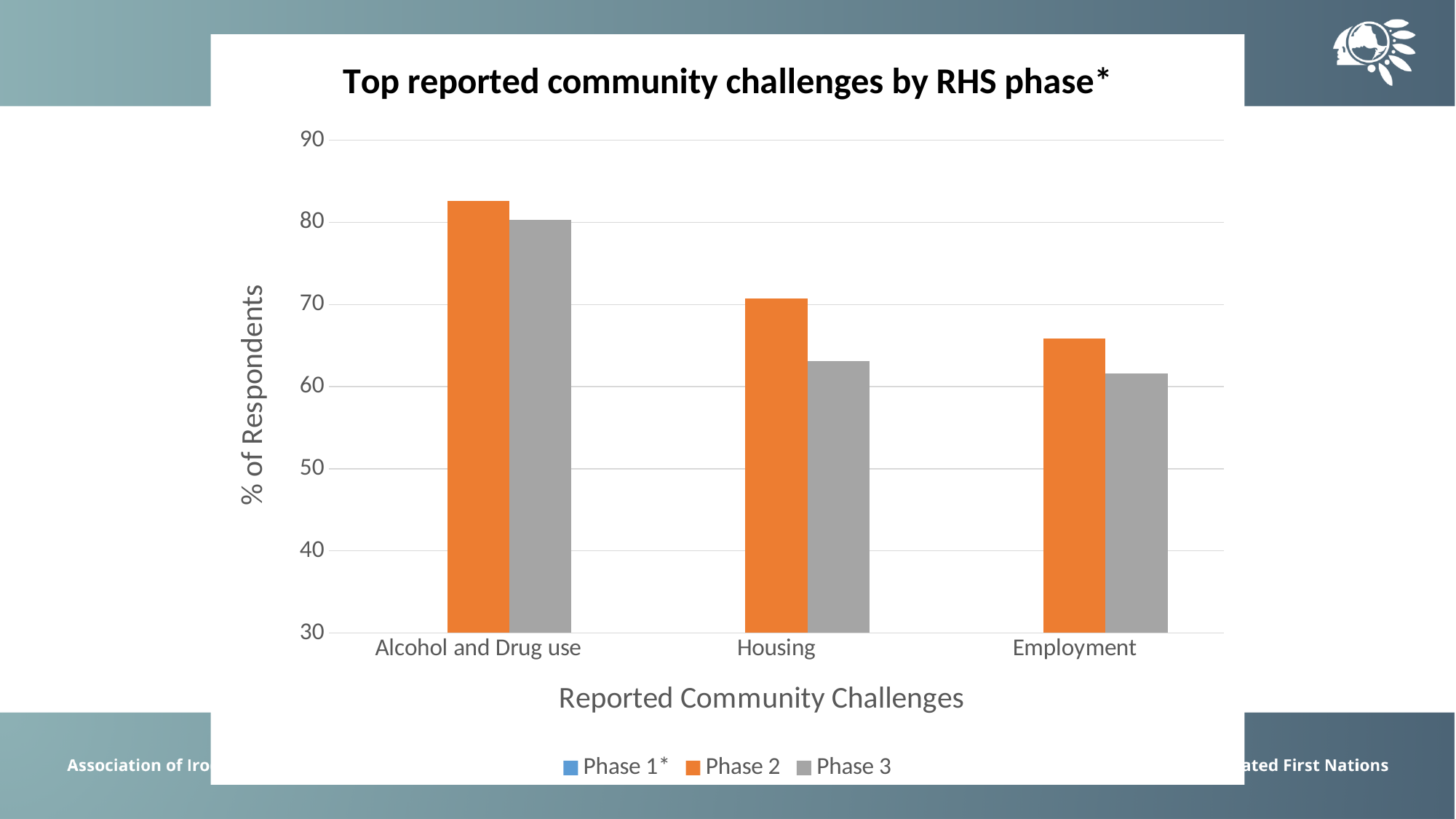
Do the Phase 2 values rise or fall from Alcohol and Drug use to Employment along the x axis? fall Which category has the highest Phase 2 value? Alcohol and Drug use What is the title of the chart? Top reported community challenges by RHS phase* Is the Phase 3 value for Housing greater or less than 70? less For Housing, which is larger: the Phase 2 value or the Phase 3 value? Phase 2 What kind of chart is shown on the slide? bar chart How many categories are shown on the x axis? 3 Is the Phase 2 value for Alcohol and Drug use greater or less than 80? greater How many series does the legend list? 3 Is the Phase 2 value for Employment greater or less than 60? greater Which category has the lowest Phase 3 value? Employment What is the label of the y axis? % of Respondents